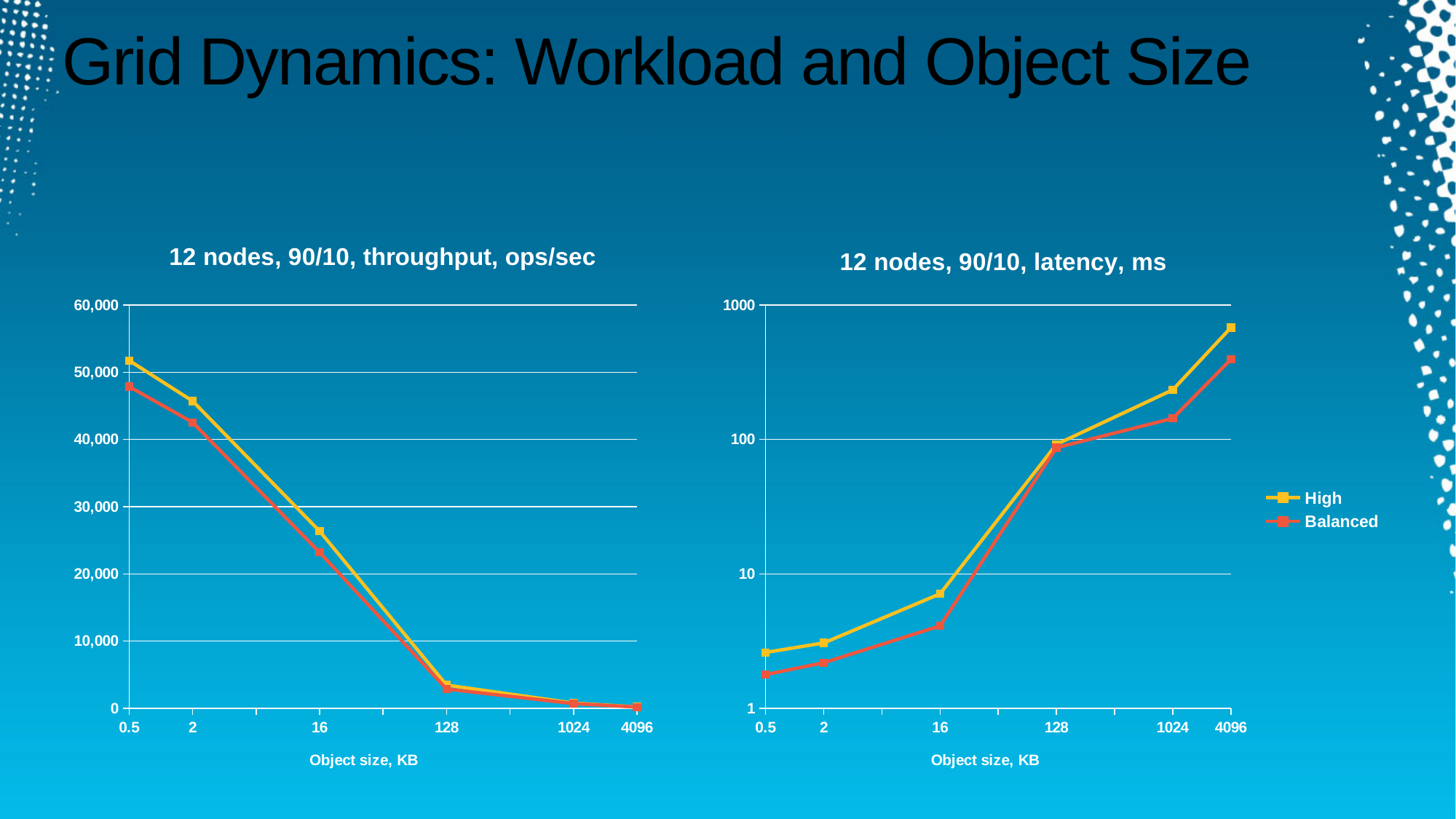
What kind of chart is the '12 nodes, 90/10, throughput, ops/sec' chart? line chart In the '12 nodes, 90/10, latency, ms' chart, do the values rise or fall as object size increases? rise How many series does the legend list for the charts on this slide? 2 In the '12 nodes, 90/10, latency, ms' chart, is the High value at 4096 KB greater or less than 100? greater In the '12 nodes, 90/10, throughput, ops/sec' chart, which series has the higher value at 2 KB, High or Balanced? High In the '12 nodes, 90/10, throughput, ops/sec' chart, do the values rise or fall as object size increases? fall In the '12 nodes, 90/10, throughput, ops/sec' chart, is the High value at 16 KB greater or less than 20,000? greater In the '12 nodes, 90/10, throughput, ops/sec' chart, how many object-size points are plotted along the x axis? 6 In the '12 nodes, 90/10, latency, ms' chart, is the Balanced value at 16 KB greater or less than 10? less What is the x-axis label on the '12 nodes, 90/10, latency, ms' chart? Object size, KB